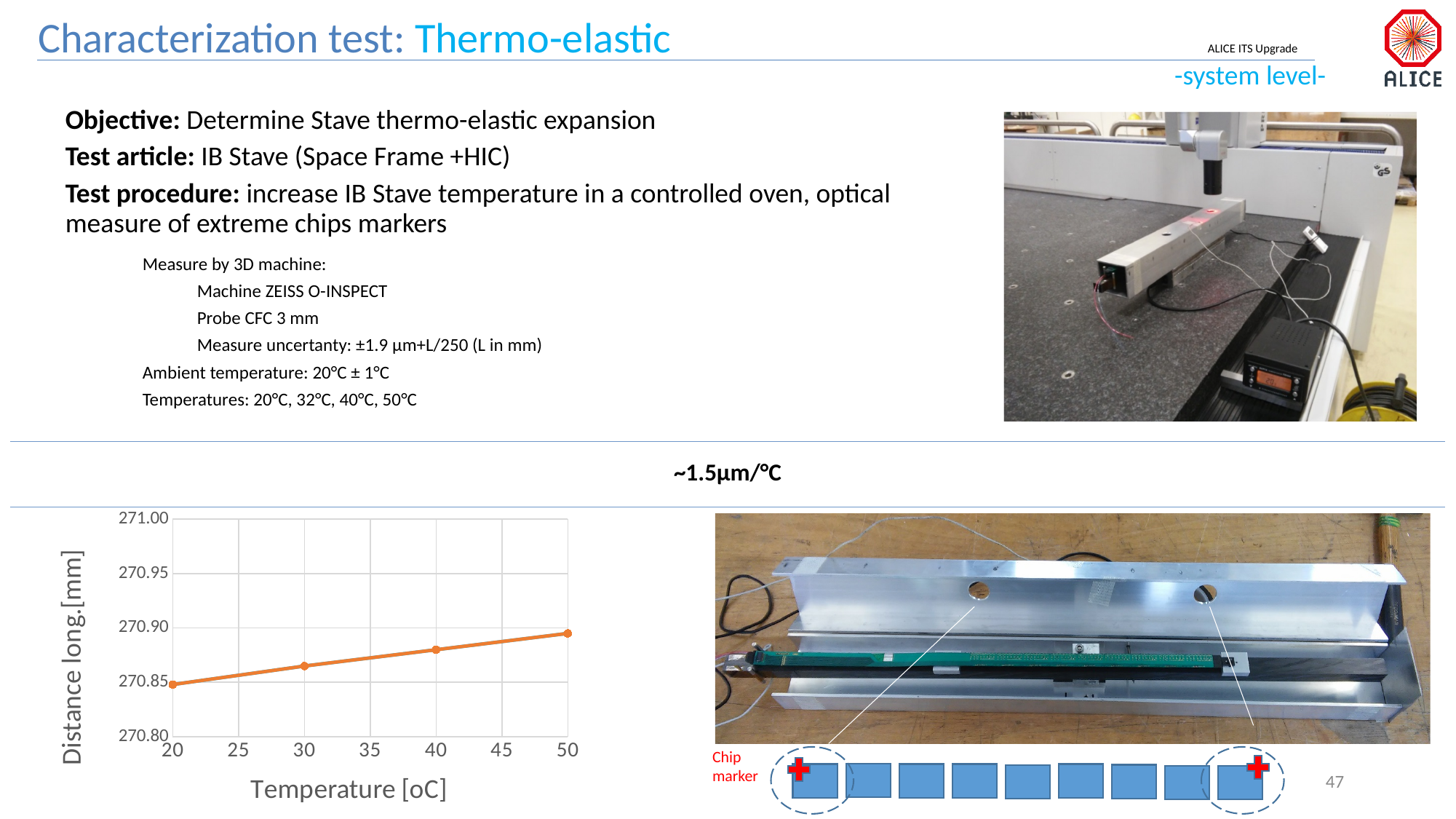
Is the plotted distance at 50 °C greater or less than 270.85? greater At which temperature is the plotted distance lowest? 20 Is the plotted distance at 30 °C greater or less than 270.85? greater Which has the larger plotted distance, 50 °C or 20 °C? 50 °C What kind of chart is shown at the bottom left of the slide? line chart What is the label of the x axis on the line chart? Temperature [oC] Is the plotted distance at 40 °C greater or less than 270.90? less What is the label of the y axis on the line chart? Distance long.[mm] At which temperature is the plotted distance highest? 50 How many data points are plotted on the line chart? 4 Does the plotted distance rise or fall as temperature increases along the x axis? rise